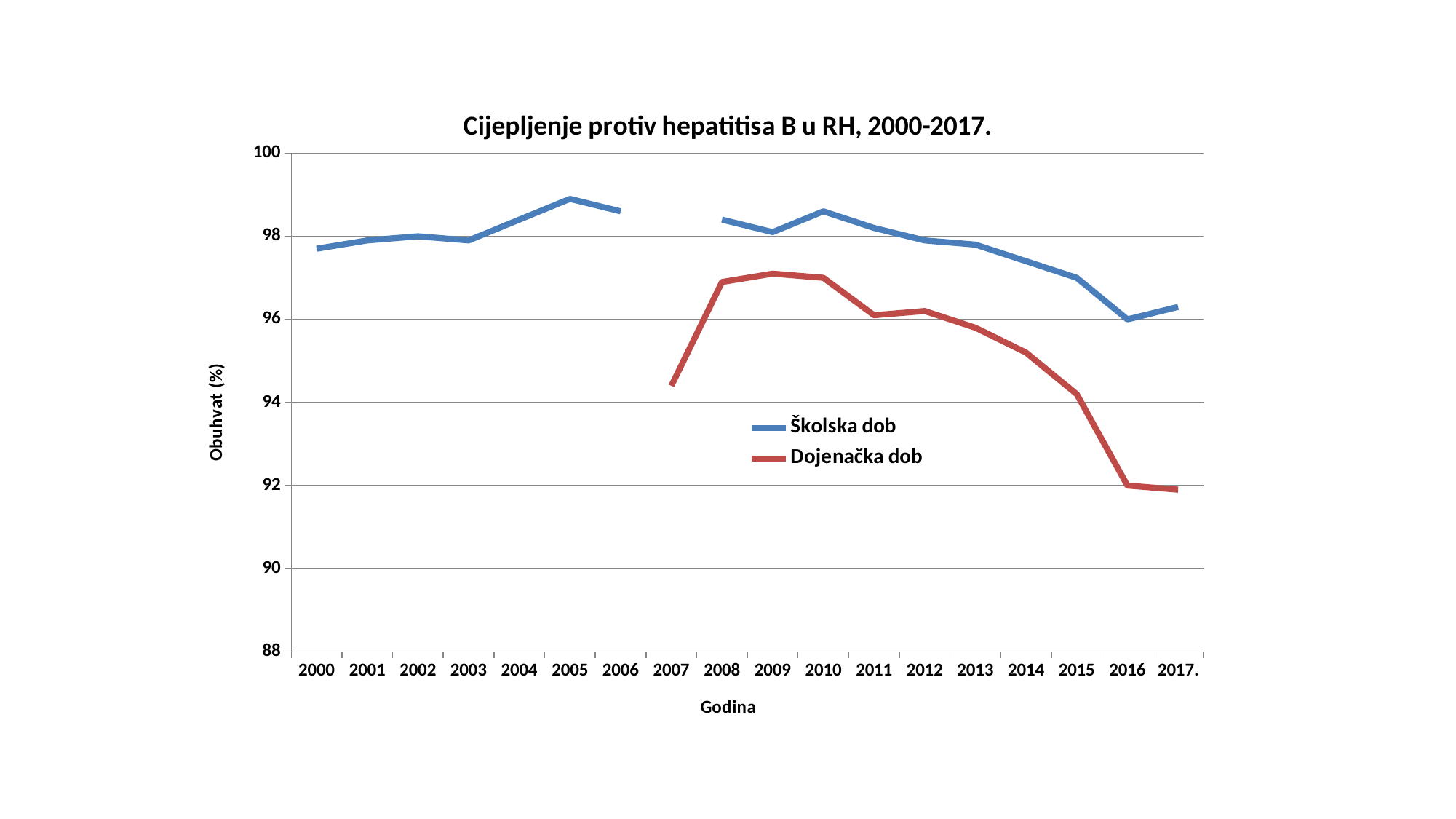
Does the Dojenačka dob series rise or fall from 2010 to 2017? fall In which year does the Školska dob series reach its highest value? 2005 What is the title of the chart? Cijepljenje protiv hepatitisa B u RH, 2000-2017. Is the value for Školska dob in 2000 greater or less than 98? less Is the value for Dojenačka dob in 2007 greater or less than 96? less Is the value for Školska dob in 2005 greater or less than 98? greater In 2010, which series has the higher value, Školska dob or Dojenačka dob? Školska dob How many series does the legend list? 2 How many years are shown on the x axis? 18 What kind of chart is shown on the slide? line chart In which year does the Školska dob series reach its lowest value? 2016